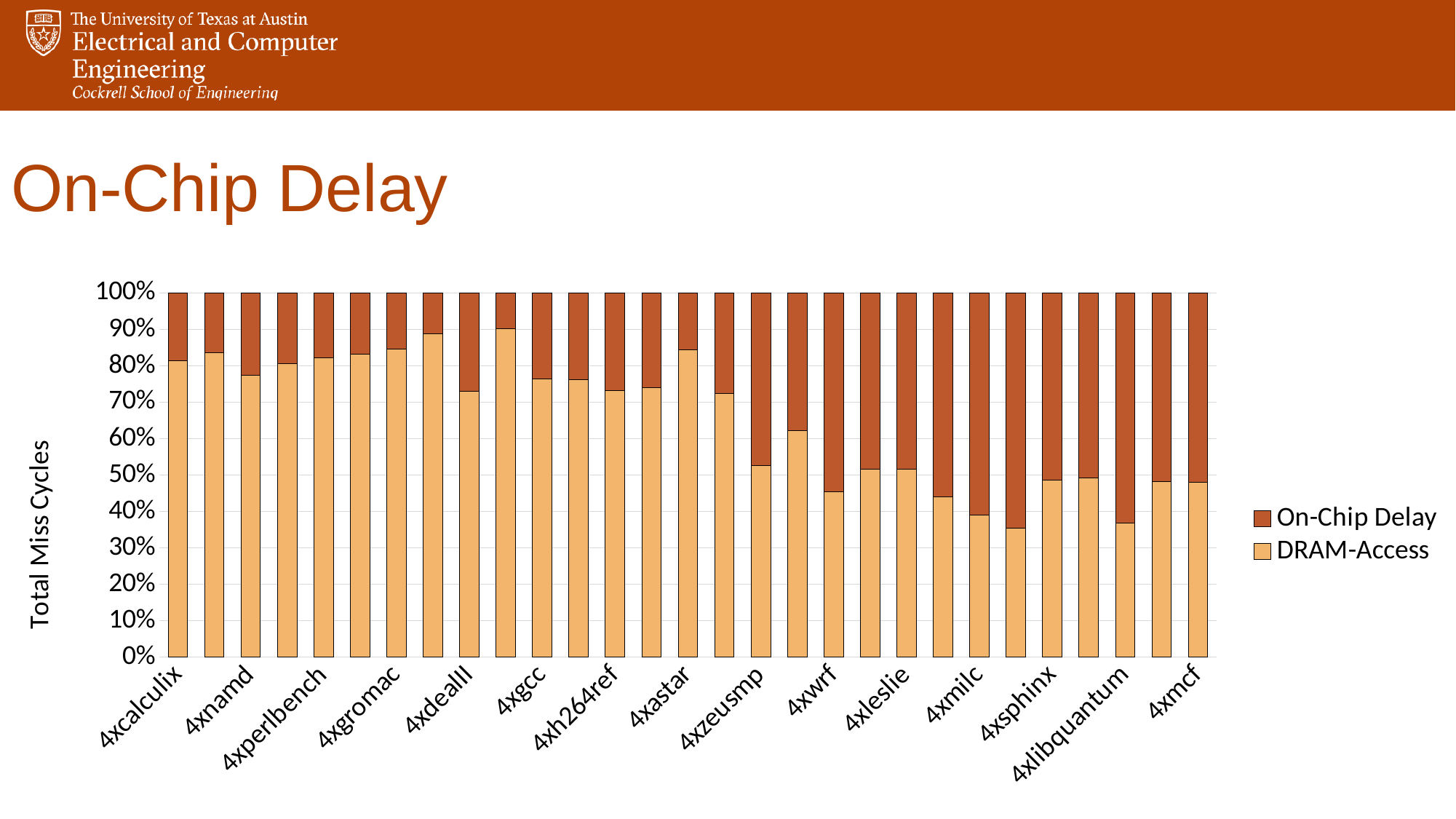
Is the DRAM-Access share for 4xcalculix greater or less than 70%? greater Is the DRAM-Access share for 4xastar greater or less than 80%? greater Is the DRAM-Access share for 4xmilc greater or less than 50%? less What is the title of the chart on the slide? On-Chip Delay What is the label of the vertical axis? Total Miss Cycles Does the DRAM-Access share generally rise or fall moving from left to right along the x axis? fall Which has a larger DRAM-Access share, 4xcalculix or 4xlibquantum? 4xcalculix How many series does the legend list? 2 What kind of chart is shown on the slide? Stacked bar chart